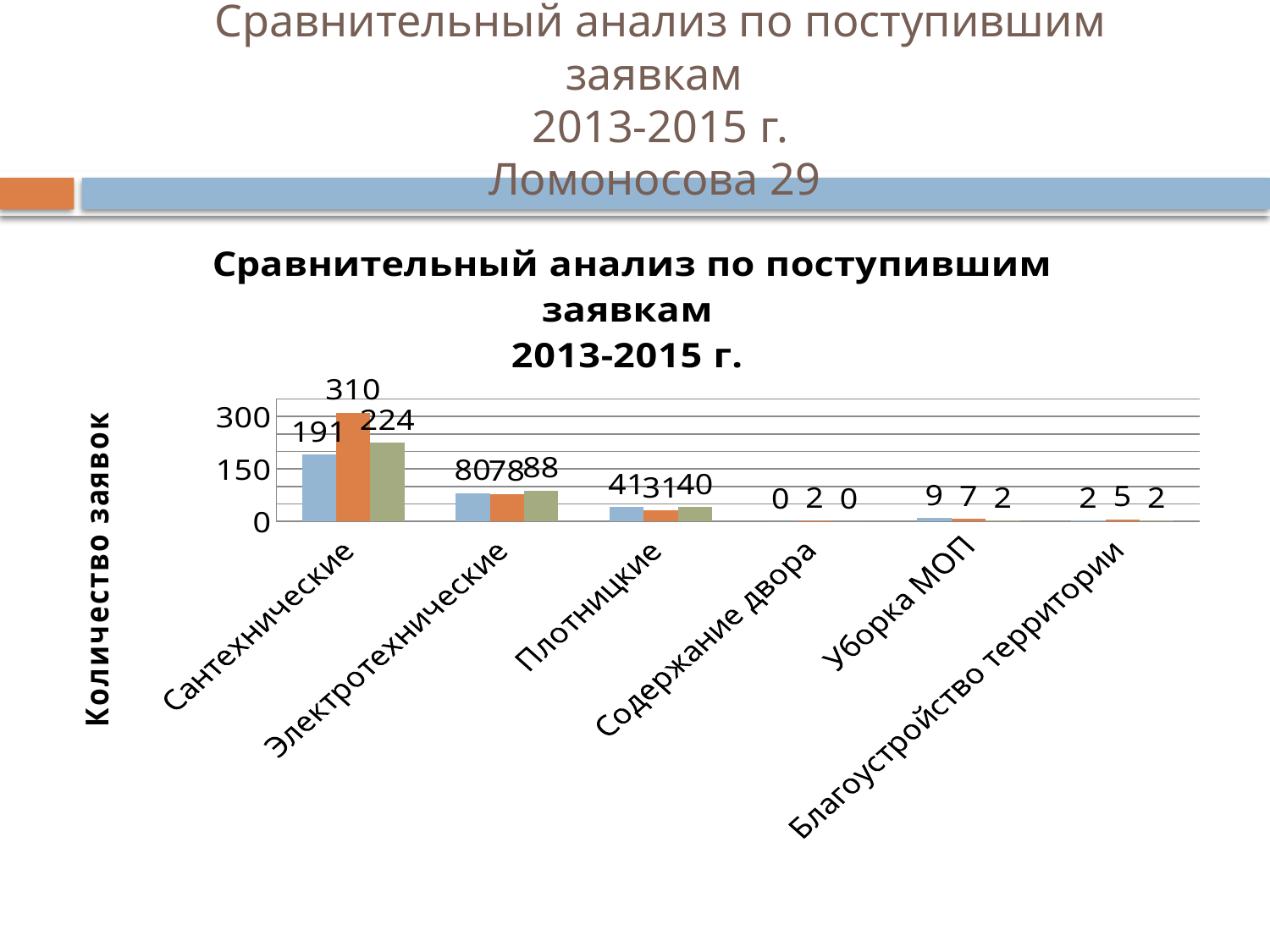
How many categories are shown on the x axis of the chart? 6 What is the value of the green (third) bar for Плотницкие? 40 What is the label of the vertical axis of the chart? Количество заявок What is the value of the orange (middle) bar for Сантехнические? 310 How many bars are shown for each category in the chart? 3 What type of chart is shown on the slide? bar chart Which category has the highest value in the chart? Сантехнические What is the value of the blue (first) bar for Электротехнические? 80 What is the difference between the orange bar and the blue bar for Сантехнические? 119 Which category has the lowest values in the chart? Содержание двора Which is larger for Уборка МОП: the blue (first) bar or the green (third) bar? the blue (first) bar What is the value of the orange (middle) bar for Благоустройство территории? 5